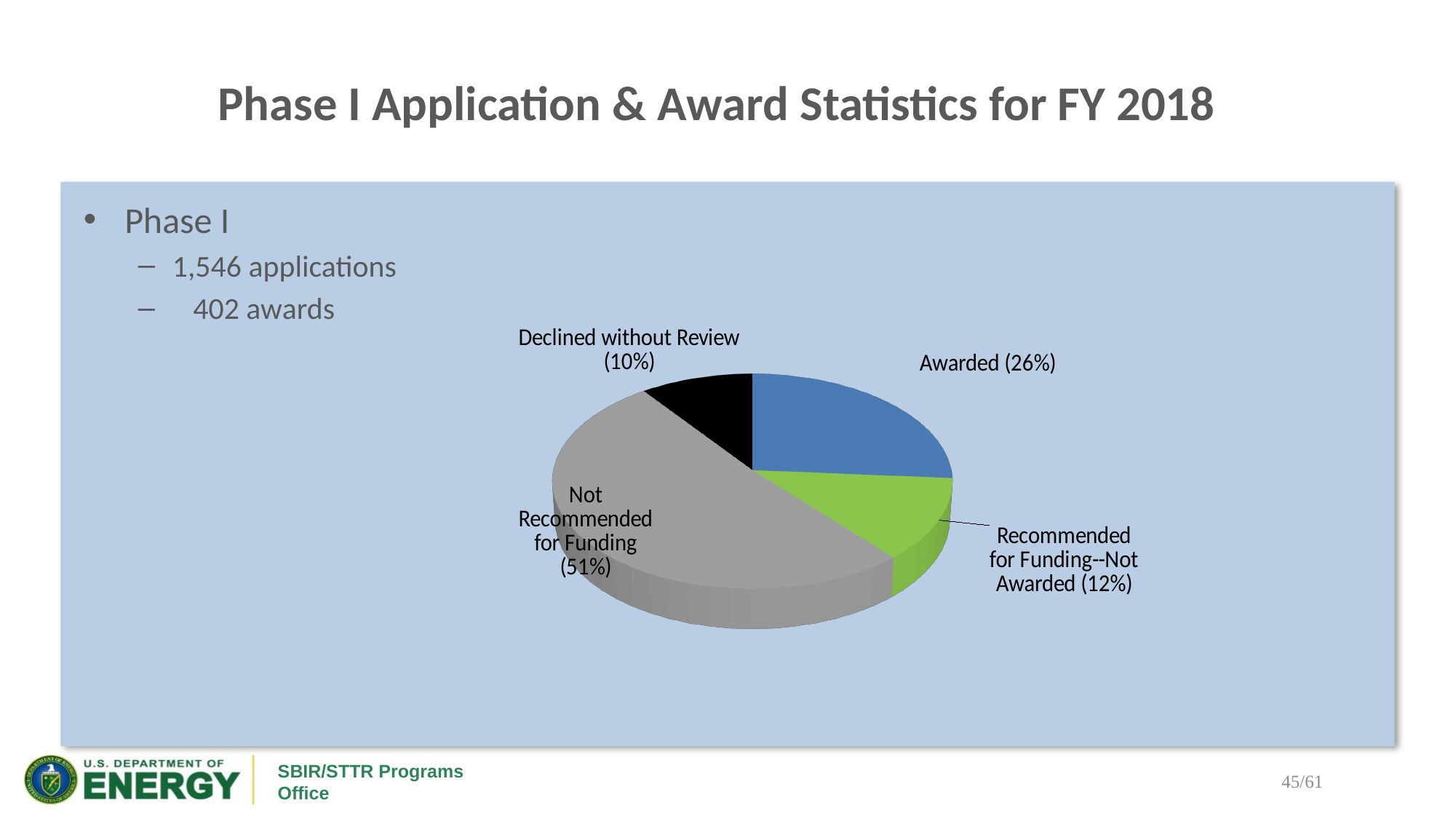
Which slice of the pie is the smallest? Declined without Review What share of the pie is labelled Declined without Review? 10% What share of the pie is labelled Recommended for Funding--Not Awarded? 12% How many slices does the pie chart have? 4 What is the difference in percentage points between the Not Recommended for Funding slice and the Awarded slice? 25 Which is larger, the Awarded slice or the Recommended for Funding--Not Awarded slice? Awarded What colour is the Awarded slice of the pie? Blue What colour is the Declined without Review slice of the pie? Black What share of the pie is labelled Not Recommended for Funding? 51% What kind of chart is shown on the slide? Pie chart Which slice of the pie is the largest? Not Recommended for Funding